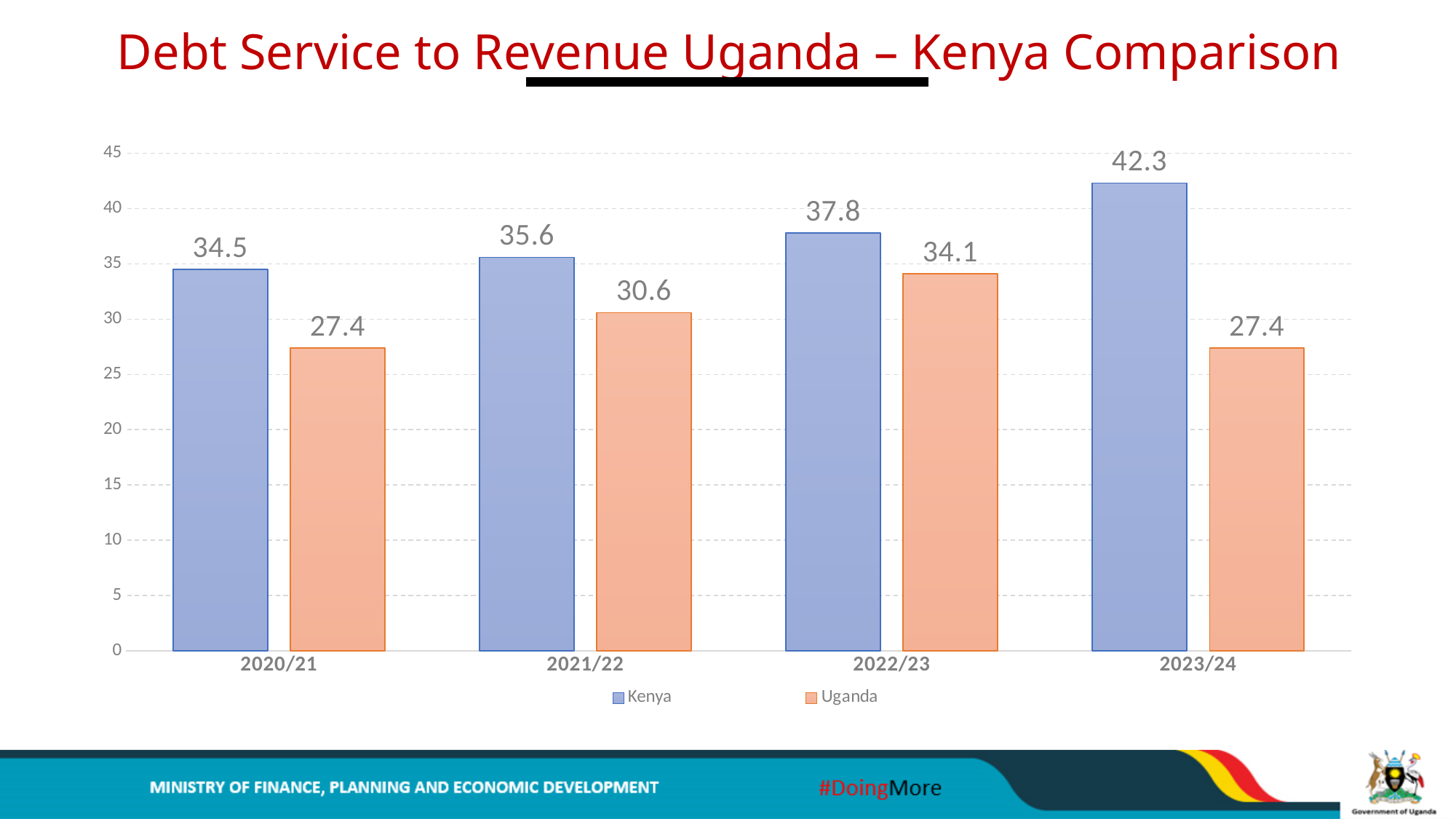
How many years are shown on the x axis? 4 Which is larger in 2022/23, the Kenya value or the Uganda value? Kenya What is the difference between the Kenya and Uganda values in 2020/21? 7.1 What kind of chart is shown on the slide? Bar chart What is the value for Uganda in 2021/22? 30.6 What is the difference between the Kenya and Uganda values in 2023/24? 14.9 How many series does the legend list? 2 In which year is the Kenya value highest? 2023/24 Do the Kenya values rise or fall from 2020/21 to 2023/24? Rise What is the value for Uganda in 2022/23? 34.1 In which year is the Uganda value highest? 2022/23 What is the value for Kenya in 2023/24? 42.3